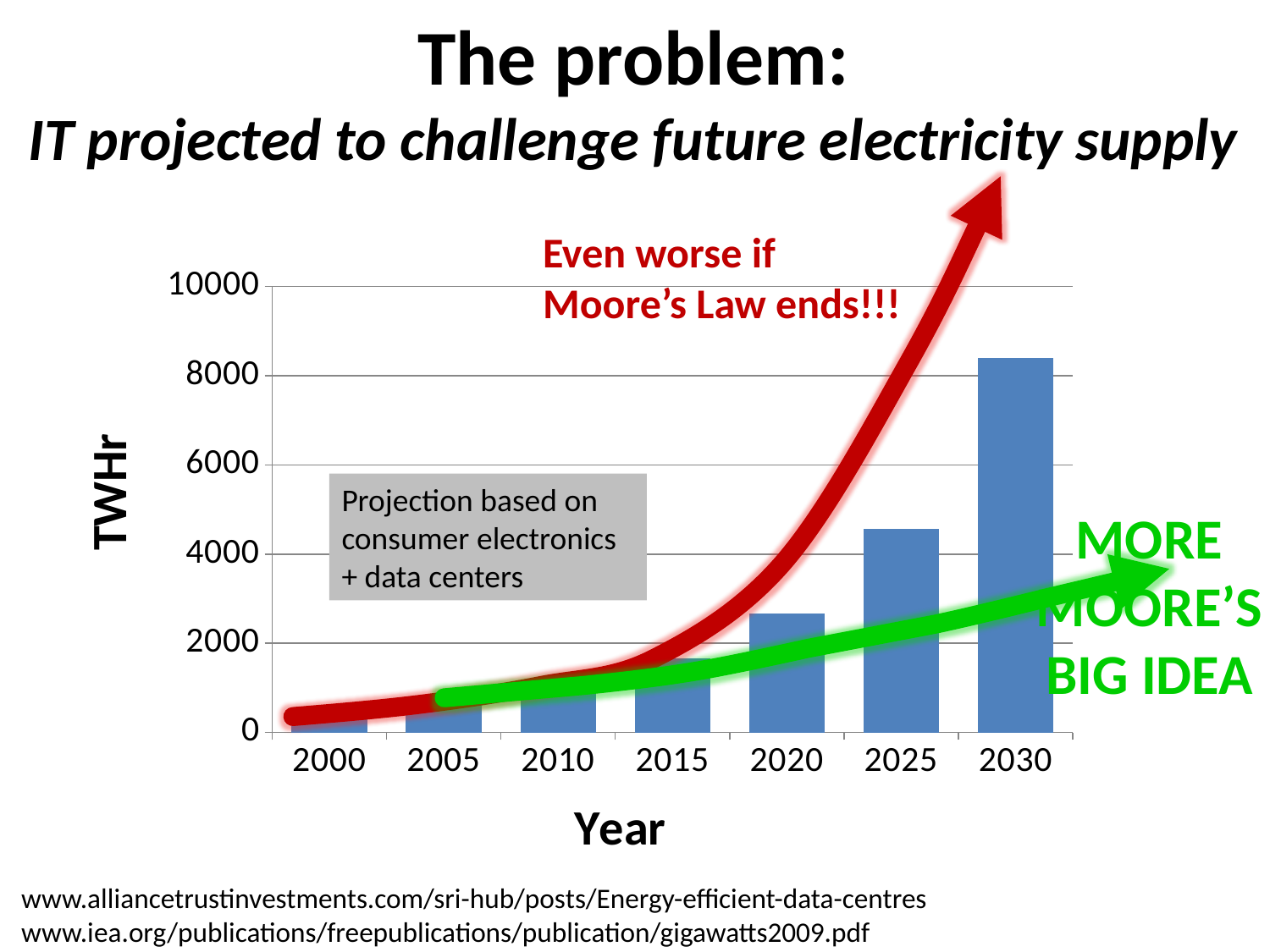
Which year has the highest value in the chart? 2030 Which year has the lowest value in the chart? 2000 Is the value for 2025 greater or less than 4000? greater Is the value for 2020 greater or less than 2000? greater Which is larger, the value for 2025 or the value for 2020? 2025 What is the label on the y axis of the chart? TWHr Is the value for 2030 greater or less than 8000? greater How many years are plotted on the x axis of the chart? 7 What kind of chart is shown on the slide? bar chart Do the values rise or fall from 2000 to 2030? rise